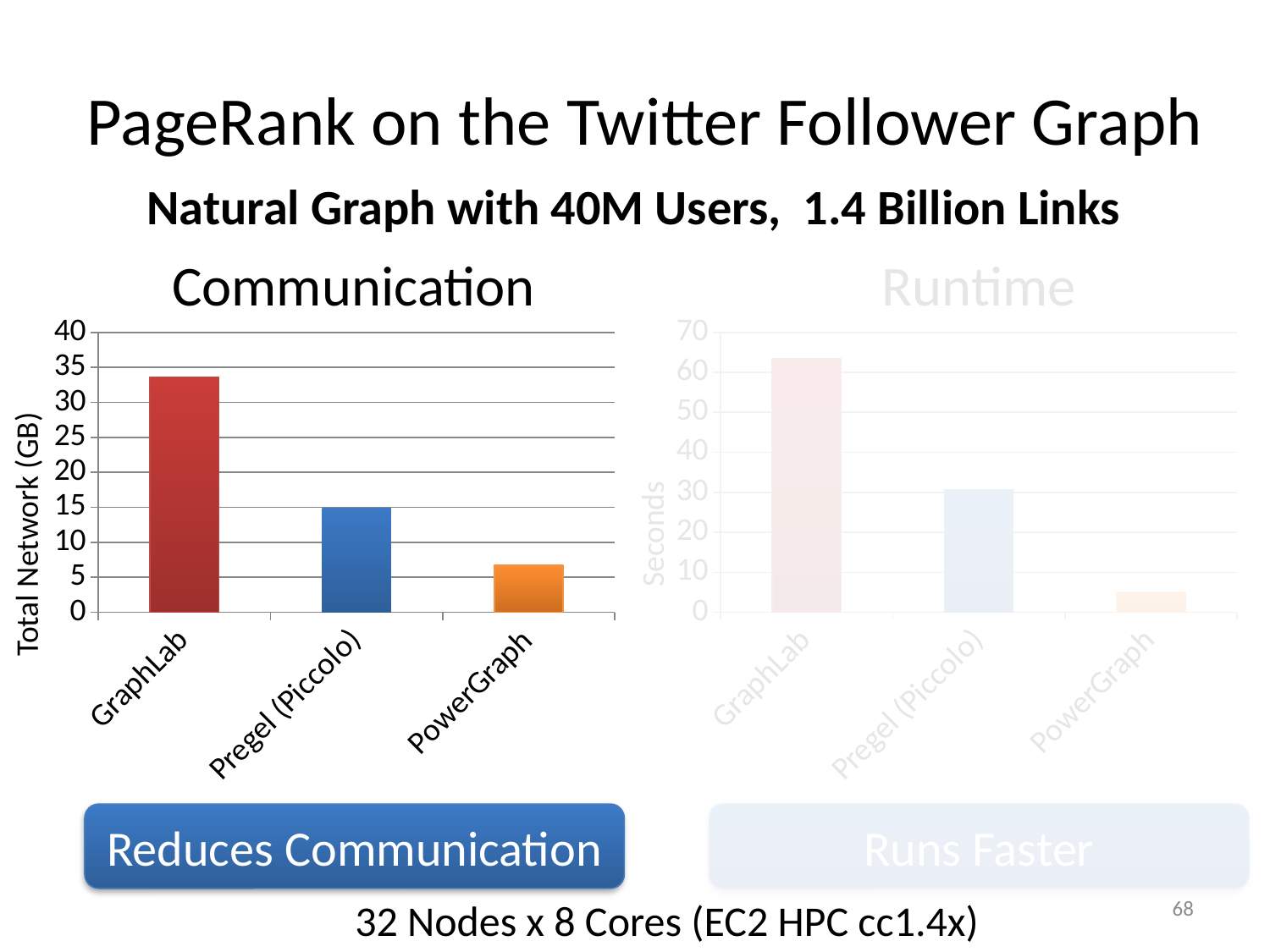
In the Communication chart, is the value for GraphLab greater or less than 30? greater In the Communication chart, which category has the highest total network usage? GraphLab What is the y-axis label of the Runtime chart? Seconds In the Runtime chart, is the value for GraphLab greater or less than 60? greater In the Communication chart, which category has the lowest total network usage? PowerGraph What is the y-axis label of the Communication chart? Total Network (GB) In the Runtime chart, is the value for PowerGraph greater or less than 10? less What kind of chart is the Communication chart? bar chart In the Runtime chart, which category has the highest runtime? GraphLab In the Communication chart, which is larger, the value for Pregel (Piccolo) or the value for PowerGraph? Pregel (Piccolo) How many categories are shown in the Communication chart? 3